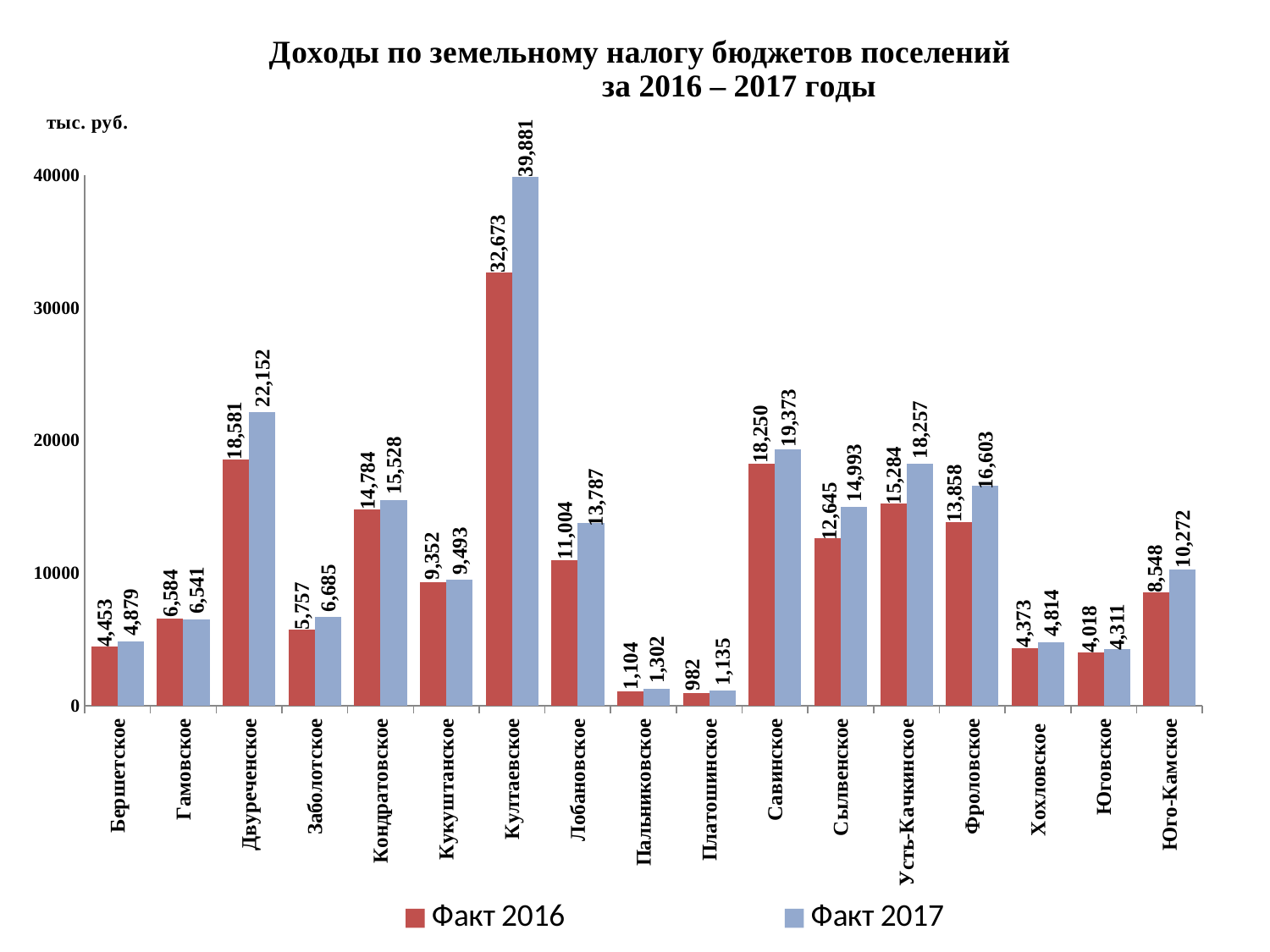
How many settlements are shown on the x axis? 17 What kind of chart is shown on the slide? Bar chart What is the Факт 2016 value for Юго-Камское? 8,548 For Гамовское, which is larger: the Факт 2016 value or the Факт 2017 value? Факт 2016 What is the Факт 2016 value for Двуреченское? 18,581 What is the difference between the Факт 2017 and Факт 2016 values for Двуреченское? 3,571 Which has the larger Факт 2017 value: Савинское or Усть-Качкинское? Савинское What is the Факт 2017 value for Култаевское? 39,881 Which settlement has the lowest Факт 2016 value? Платошинское What is the difference between the Факт 2017 and Факт 2016 values for Култаевское? 7,208 How many series does the legend list? 2 Which settlement has the highest Факт 2017 value? Култаевское